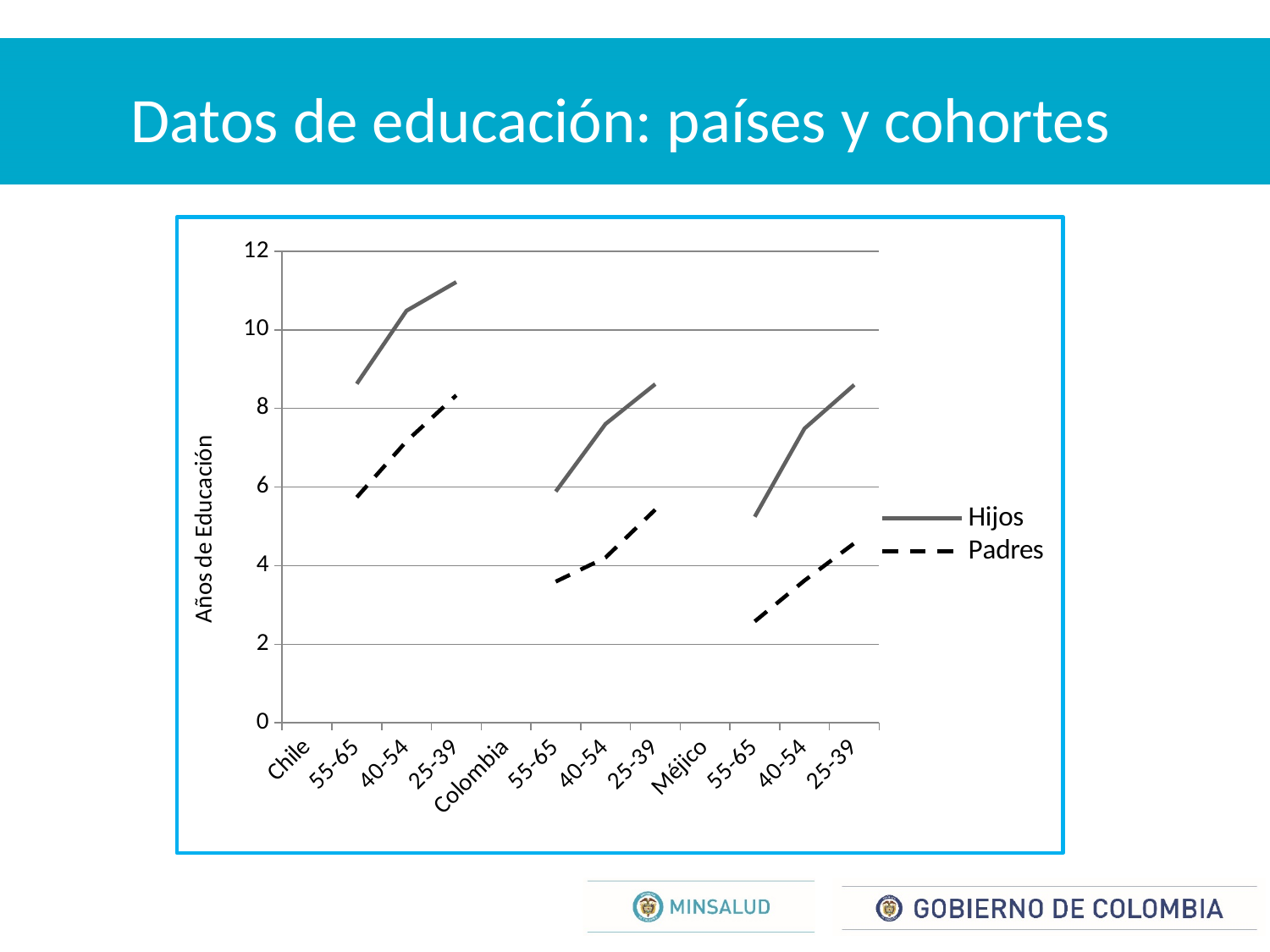
Is the Hijos value for the Chile 25-39 cohort greater or less than 10? greater Within each country, do the Hijos values rise or fall going from the 55-65 cohort to the 25-39 cohort? rise For the Chile 40-54 cohort, which series has the higher value, Hijos or Padres? Hijos How many series does the legend list? 2 Is the Padres value for the Colombia 55-65 cohort greater or less than 4? less What are the two series named in the legend? Hijos and Padres For which country and cohort does the Hijos series reach its highest value? Chile 25-39 What kind of chart is shown on the slide? line chart Is the Padres value for the Méjico 55-65 cohort greater or less than 2? greater What is the label of the vertical axis? Años de Educación Which series is drawn with a dashed line? Padres